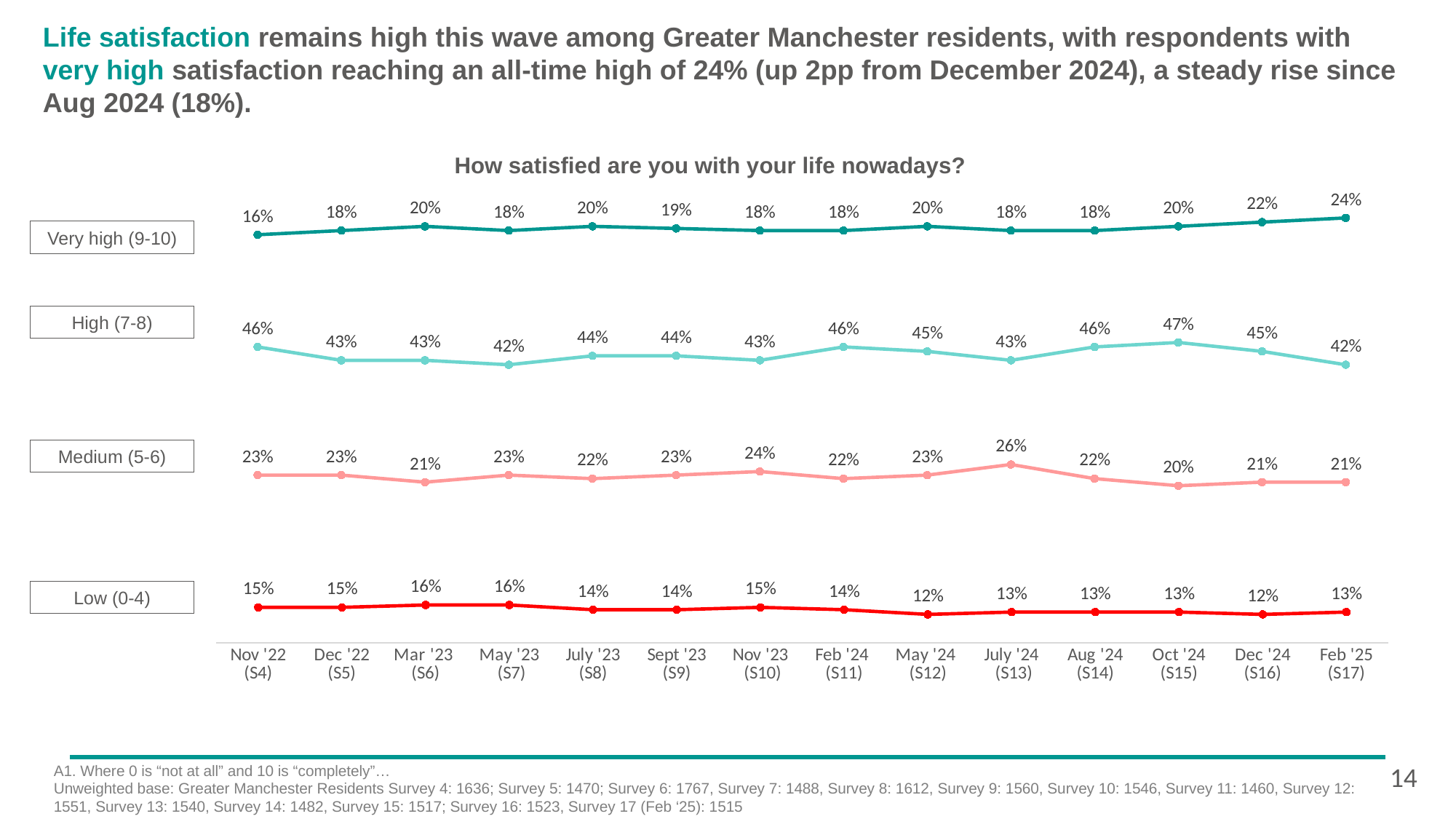
What is the difference between the Very high (9-10) values in Feb '25 (S17) and Nov '22 (S4)? 8 percentage points What is the value for High (7-8) in Oct '24 (S15)? 47% What is the title of the chart? How satisfied are you with your life nowadays? What is the value for Very high (9-10) in Feb '25 (S17)? 24% How many series are plotted on the chart? 4 What type of chart is shown on the slide? Line chart What is the value for Medium (5-6) in July '24 (S13)? 26% What is the value for Low (0-4) in Nov '22 (S4)? 15% In which survey wave does the High (7-8) series reach its highest value? Oct '24 (S15) Which is larger in Feb '25 (S17): the High (7-8) value or the Medium (5-6) value? High (7-8) How many survey waves are shown on the x axis? 14 In which survey wave does the Very high (9-10) series reach its highest value? Feb '25 (S17)